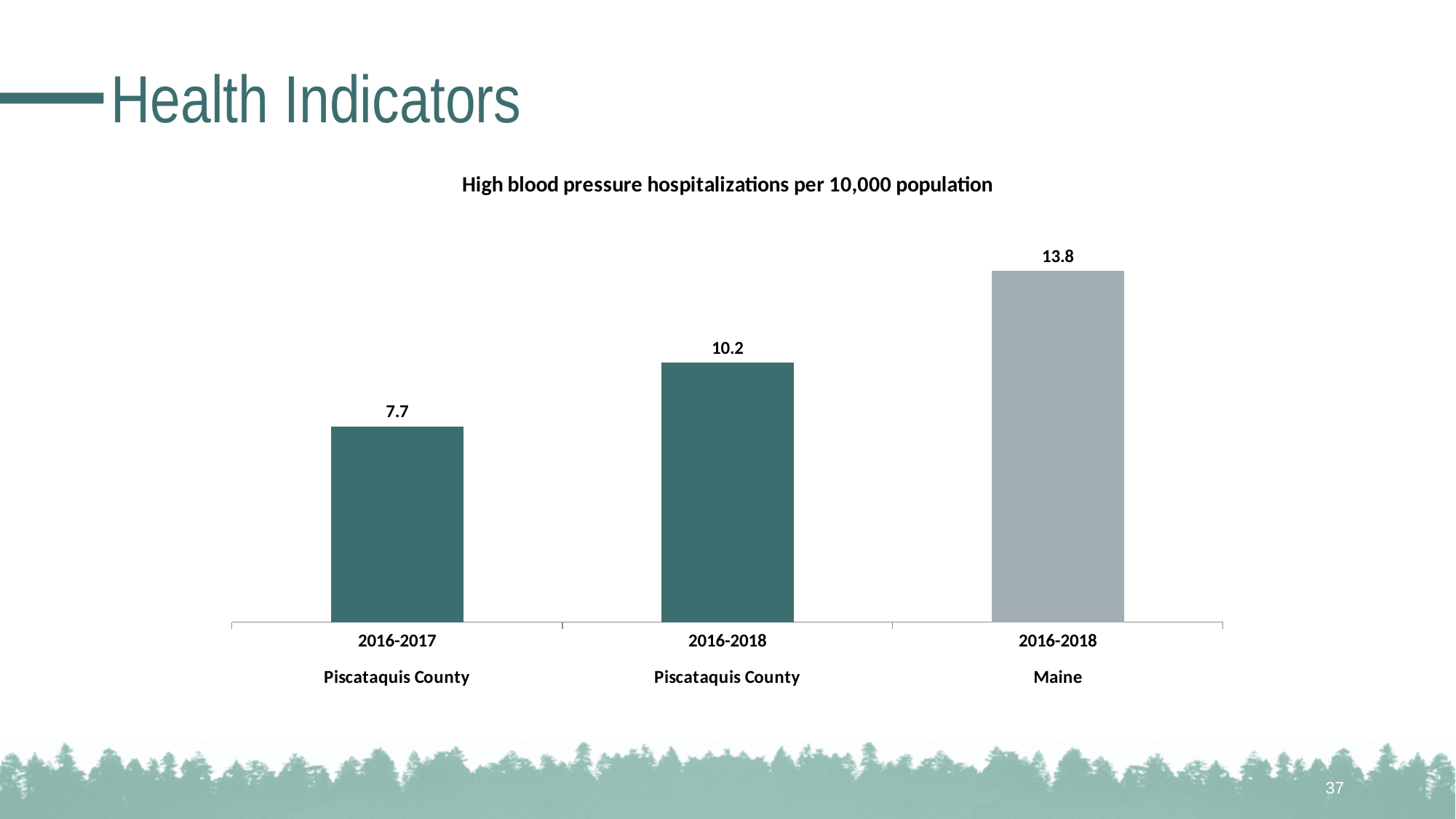
What is the value for Piscataquis County in 2016-2017? 7.7 What is the title of the chart? High blood pressure hospitalizations per 10,000 population What is the difference between the Maine 2016-2018 value and the Piscataquis County 2016-2018 value? 3.6 Do the values rise or fall from left to right across the bars? Rise What is the value for Maine in 2016-2018? 13.8 Which bar has the highest value? Maine 2016-2018 What kind of chart is shown on the slide? Bar chart What is the value for Piscataquis County in 2016-2018? 10.2 What is the difference between the Piscataquis County 2016-2018 value and the Piscataquis County 2016-2017 value? 2.5 Which bar has the lowest value? Piscataquis County 2016-2017 How many bars are shown in the chart? 3 Which is larger, the Piscataquis County 2016-2018 value or the Maine 2016-2018 value? Maine 2016-2018